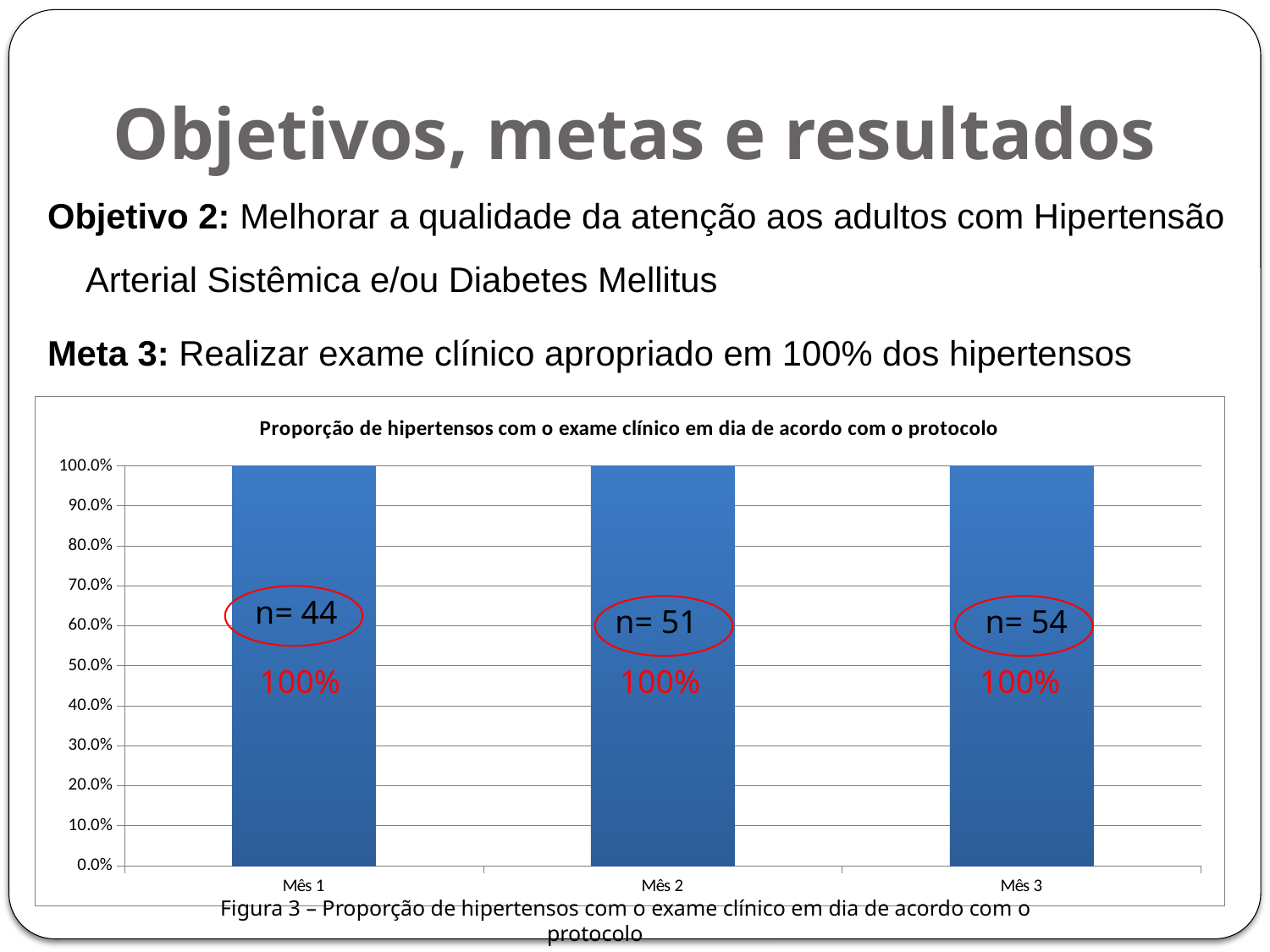
What is the value for Mês 2? 100% What is the value for Mês 3? 100% What is the n value annotated on the bar for Mês 3? n= 54 What kind of chart is shown on the slide? Bar chart Do the values rise, fall or stay the same from Mês 1 to Mês 3? Stay the same What is the difference between the values for Mês 3 and Mês 1? 0% What is the n value annotated on the bar for Mês 1? n= 44 What is the value for Mês 1? 100% What is the n value annotated on the bar for Mês 2? n= 51 Is the value for Mês 2 greater or less than 50.0%? greater What is the title of the chart? Proporção de hipertensos com o exame clínico em dia de acordo com o protocolo How many categories (months) are shown on the x axis? 3